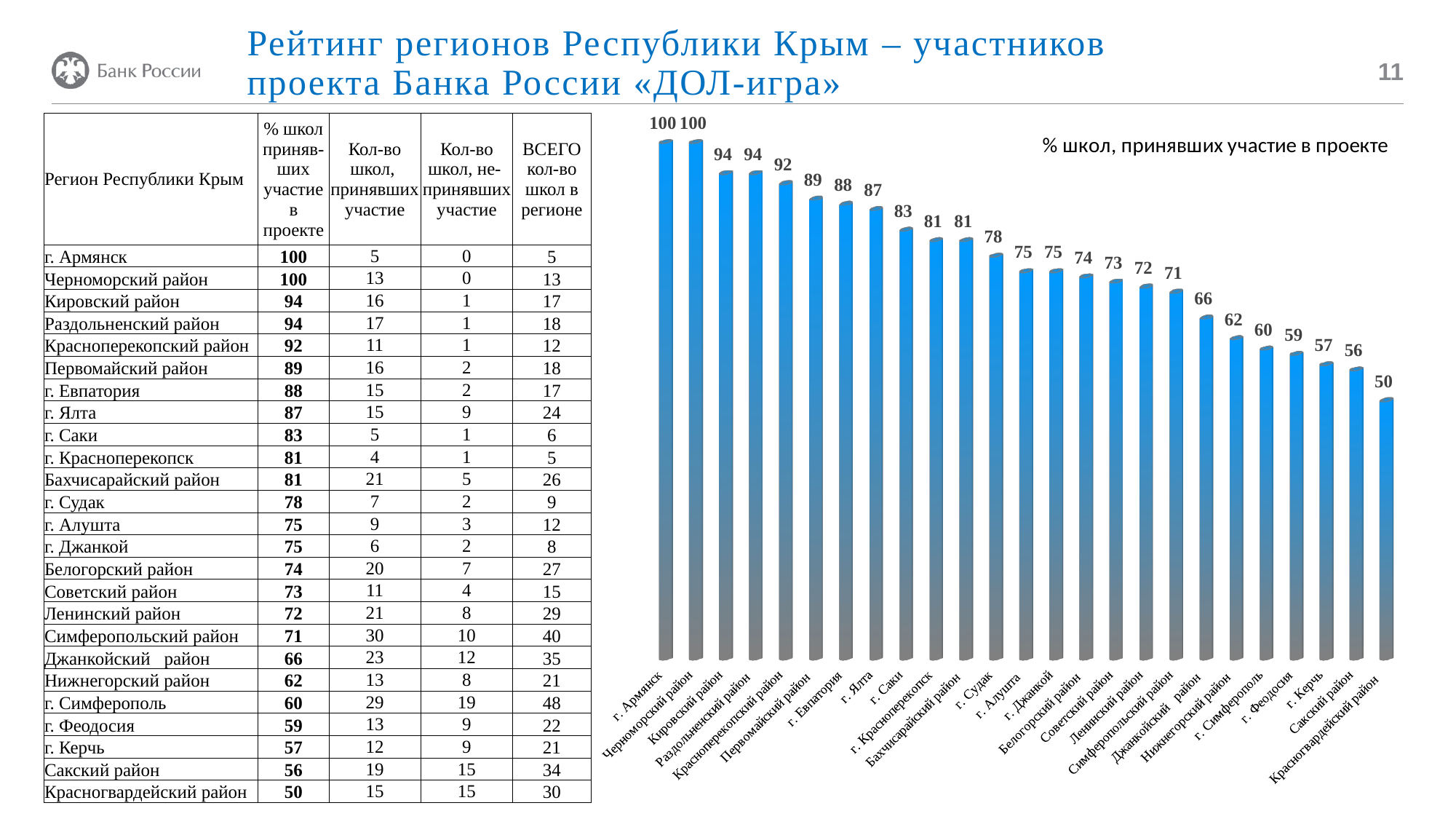
How many categories are plotted in the chart? 25 What is the value for Нижнегорский район in the chart? 62 Which category has the lowest value in the chart? Красногвардейский район What is the difference between the values for Кировский район and Сакский район? 38 What is the value for г. Судак in the chart? 78 What is the difference between the values for г. Ялта and г. Керчь? 30 What is the value for Джанкойский район in the chart? 66 What kind of chart is shown on the slide? bar chart Which is larger, the value for Белогорский район or the value for г. Симферополь? Белогорский район What is the title of the chart? % школ, принявших участие в проекте Do the values rise or fall from left to right along the x axis? fall What is the value for г. Евпатория in the chart? 88